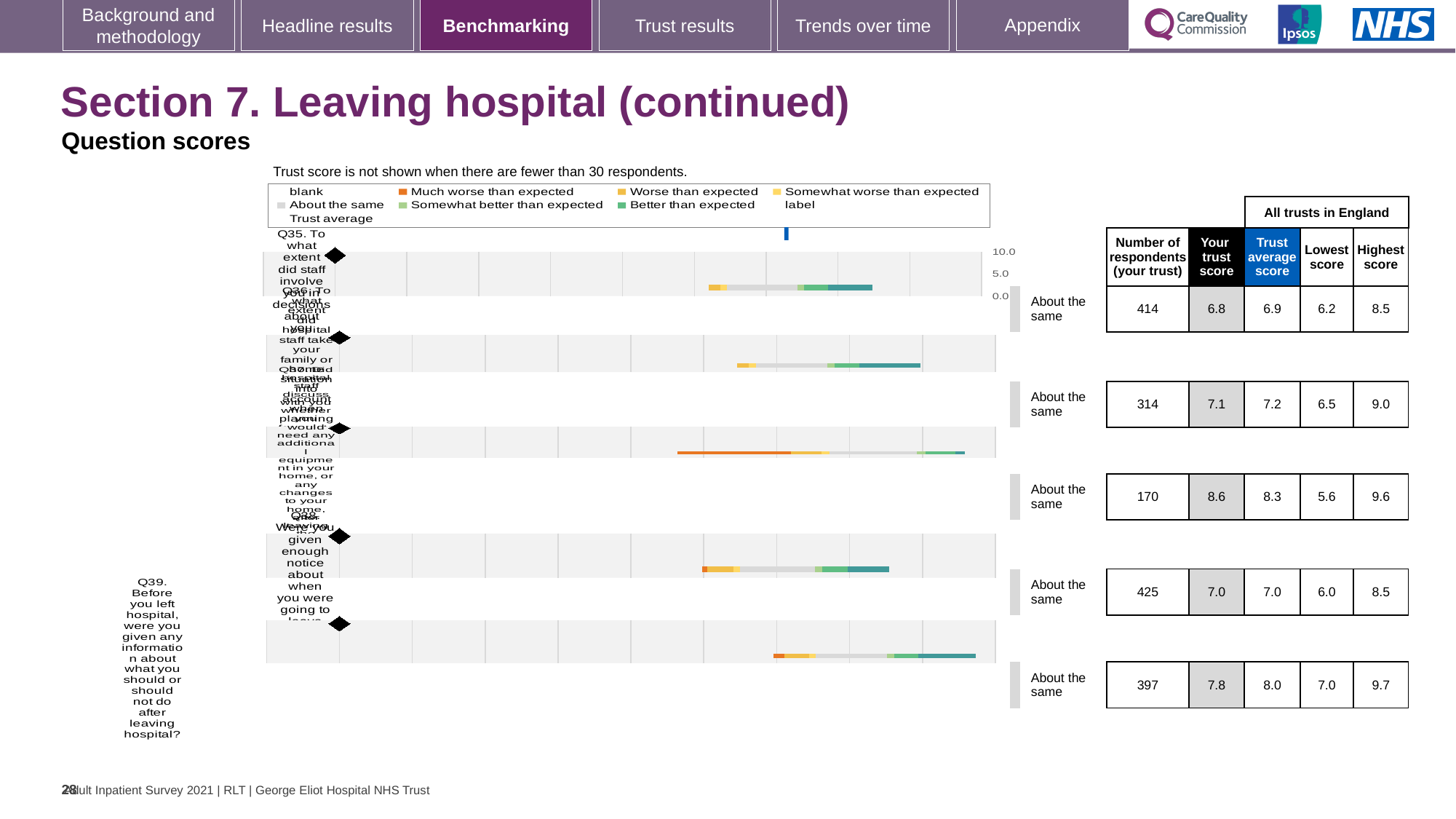
What benchmark category is shown for every question row on this slide? About the same According to the note above the chart, when is the trust score not shown? When there are fewer than 30 respondents What kind of chart is used on this slide? Bar chart What is the difference between the highest score and the lowest score for the last row (Q39)? 2.7 What is the highest score among all trusts in England for the third row (Q37)? 9.6 What is the 'Your trust score' for the last row (Q39, information about what you should or should not do after leaving hospital)? 7.8 For the third row (Q37), is your trust score higher or lower than the trust average score? Higher What is the trust average score for all trusts in England for the last row (Q39)? 8.0 How many question rows are shown in the chart? 5 Which row has the lowest number of respondents for your trust? Q37 (third row), 170 How many respondents from your trust answered the first row question (Q35)? 414 Which row has the highest 'Your trust score'? Q37 (third row), 8.6